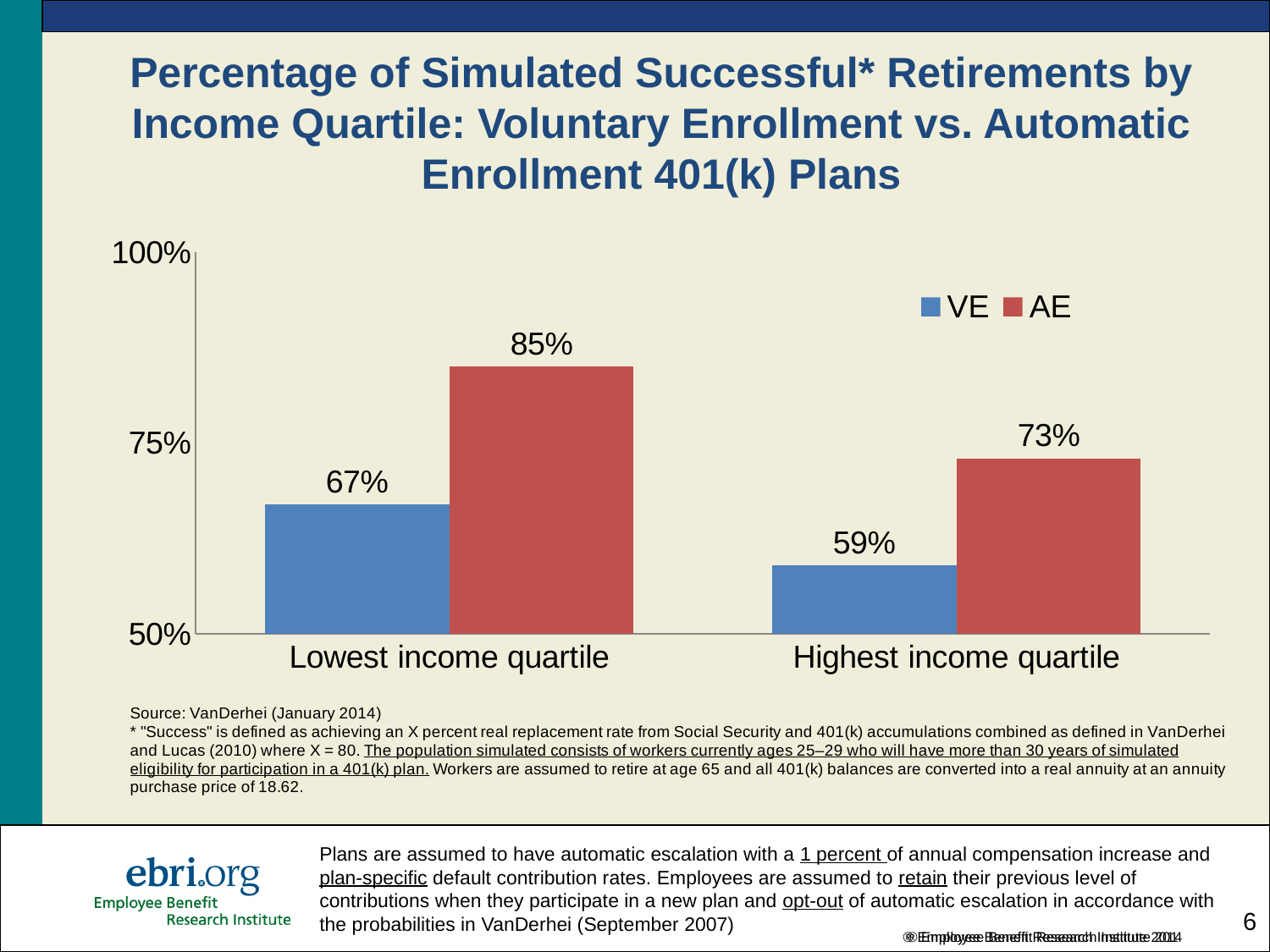
Which is larger for the Highest income quartile, VE or AE? AE What is the AE value for the Highest income quartile? 73% Which category has the highest AE value? Lowest income quartile What kind of chart is shown on the slide? Bar chart What is the difference between the AE and VE values for the Lowest income quartile? 18% What is the VE value for the Highest income quartile? 59% What is the AE value for the Lowest income quartile? 85% How many income quartile categories are shown on the x axis? 2 What is the difference between the AE and VE values for the Highest income quartile? 14% How many series does the legend list? 2 Which category has the lowest VE value? Highest income quartile What is the VE value for the Lowest income quartile? 67%